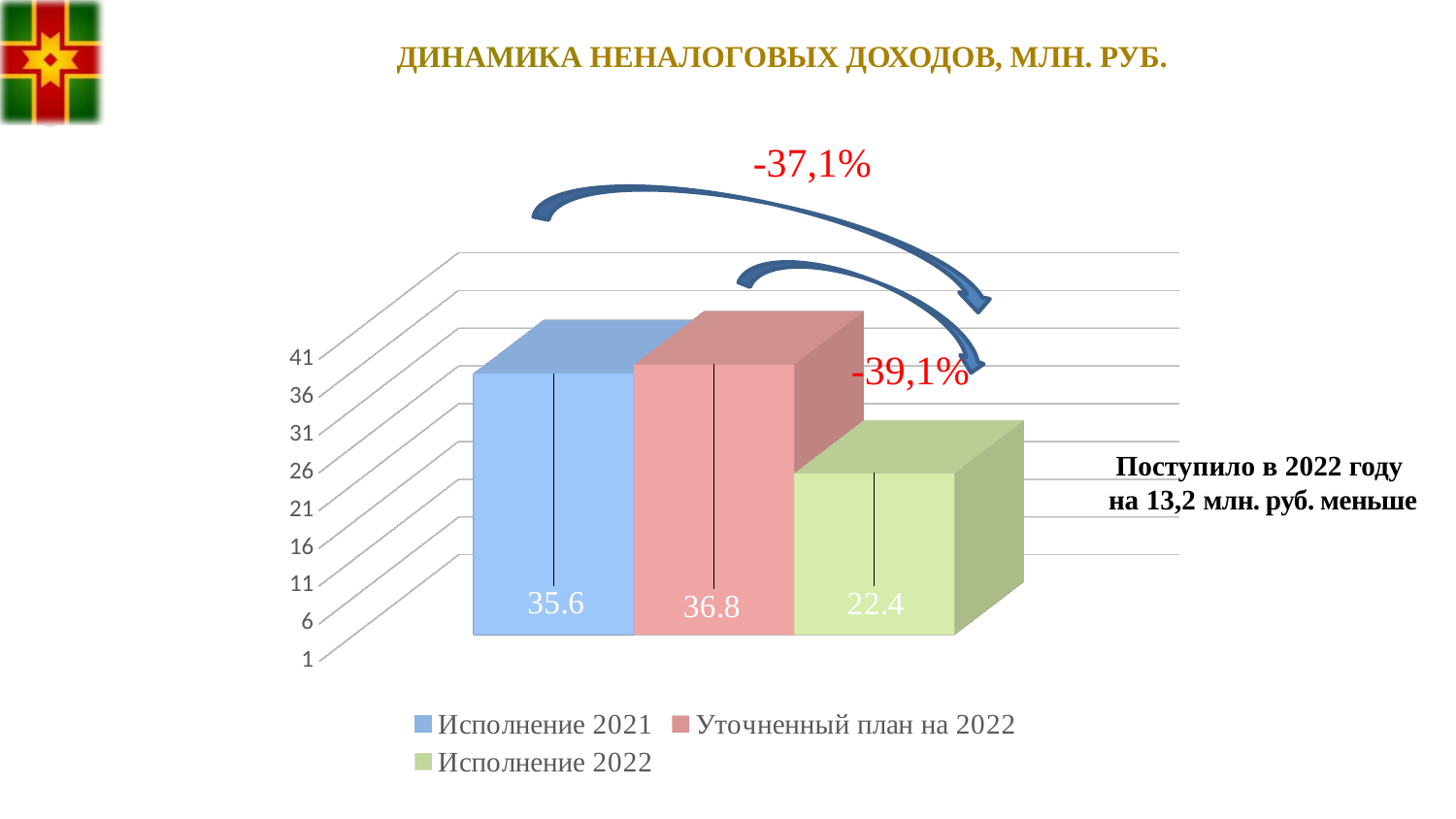
Which series has the highest value? Уточненный план на 2022 What is the title of the chart? ДИНАМИКА НЕНАЛОГОВЫХ ДОХОДОВ, МЛН. РУБ. What is the value for Исполнение 2021? 35.6 How many bars are plotted on the chart? 3 Which series has the lowest value? Исполнение 2022 What is the value for Уточненный план на 2022? 36.8 What is the difference between Уточненный план на 2022 and Исполнение 2022? 14.4 Which is larger, Исполнение 2021 or Исполнение 2022? Исполнение 2021 What is the difference between Исполнение 2021 and Исполнение 2022? 13.2 What is the value for Исполнение 2022? 22.4 How many series does the legend list? 3 What kind of chart is shown on the slide? Bar chart